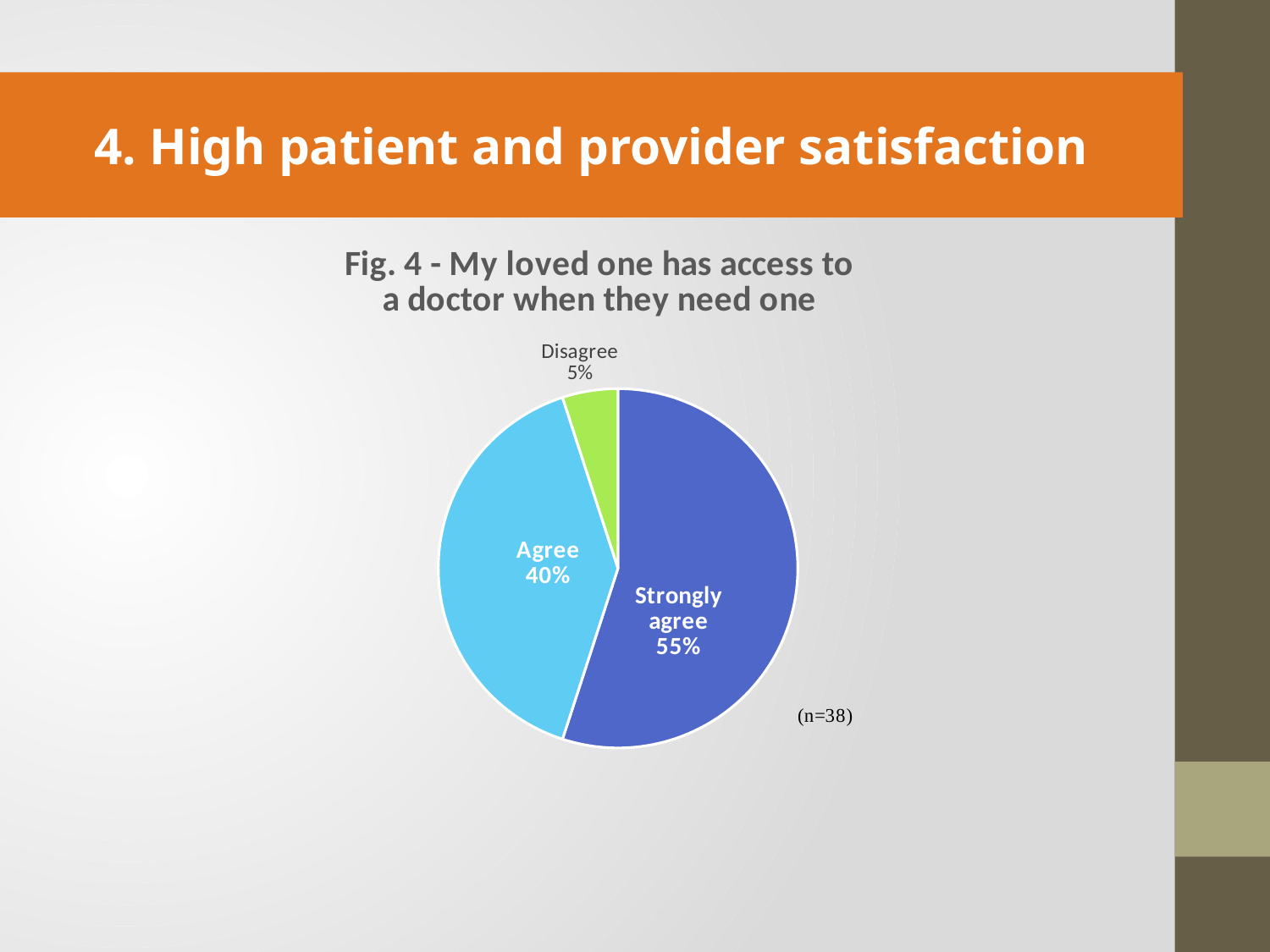
Which response category has the smallest share of the pie? Disagree What is the title of the chart? Fig. 4 - My loved one has access to a doctor when they need one What percentage of respondents answered "Agree"? 40% What is the difference in percentage points between "Strongly agree" and "Agree"? 15 How many slices does the pie chart have? 3 What sample size (n) is shown next to the chart? n=38 Which is larger, the share for "Agree" or the share for "Disagree"? Agree Which response category has the largest share of the pie? Strongly agree What percentage of respondents answered "Strongly agree"? 55% What percentage of respondents answered "Disagree"? 5% What is the combined share of respondents who answered "Strongly agree" or "Agree"? 95% What type of chart is shown on the slide? Pie chart